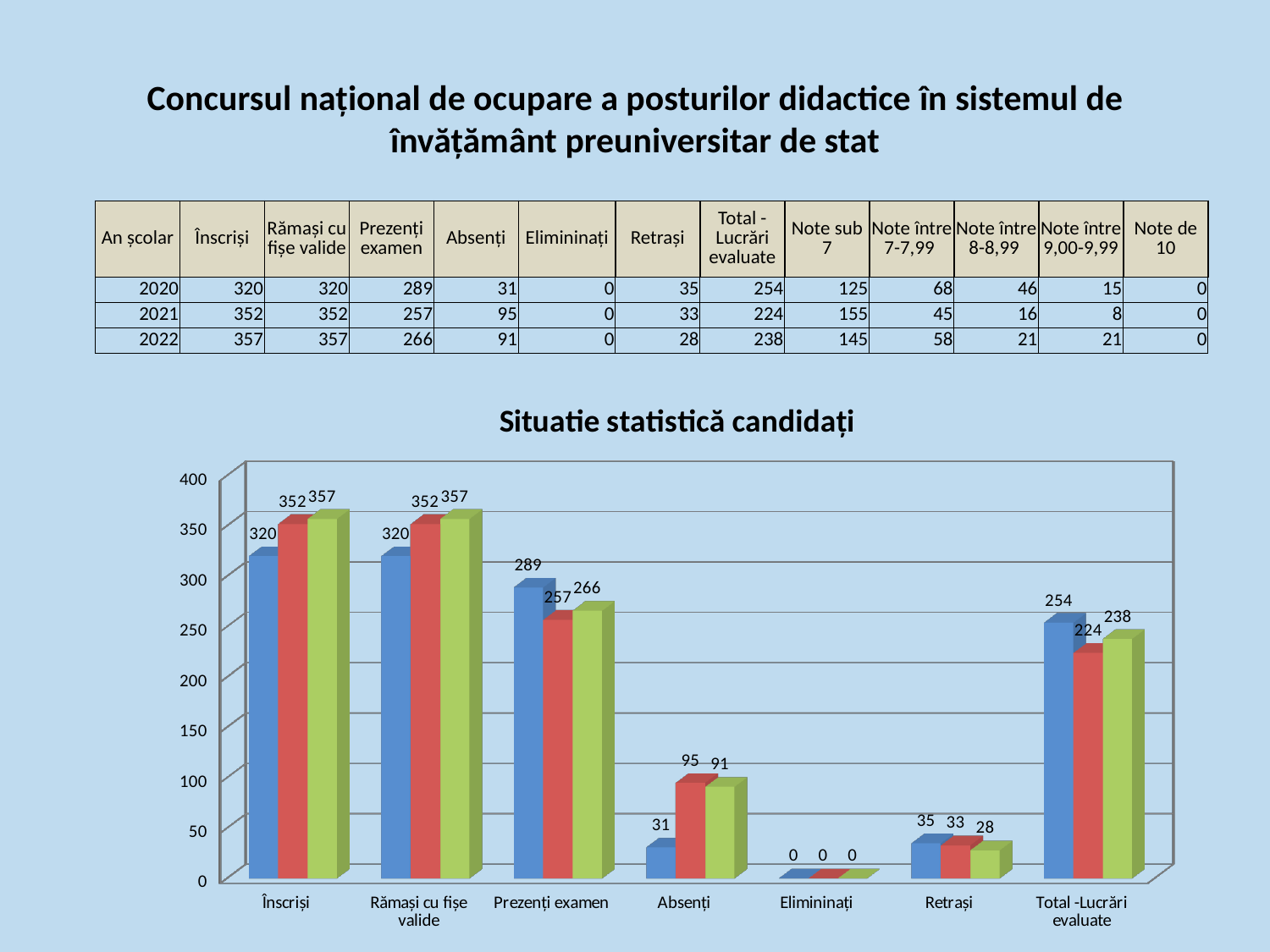
Which is larger for Prezenți examen, the red bar or the green bar? green bar Which category has the lowest values for all three bars? Elimininați What is the difference between the red bar and the blue bar for Absenți? 64 What is the difference between the blue bar and the red bar for Total -Lucrări evaluate? 30 What is the title of the chart? Situatie statistică candidați What is the value of the green bar for Retrași? 28 What type of chart is shown on the slide? bar chart What is the value of the blue bar for Prezenți examen? 289 What is the value of the red bar for Absenți? 95 How many categories are shown on the x axis of the chart? 7 Is the value of the blue bar for Înscriși greater or less than 300? greater What is the value of the green bar for Total -Lucrări evaluate? 238